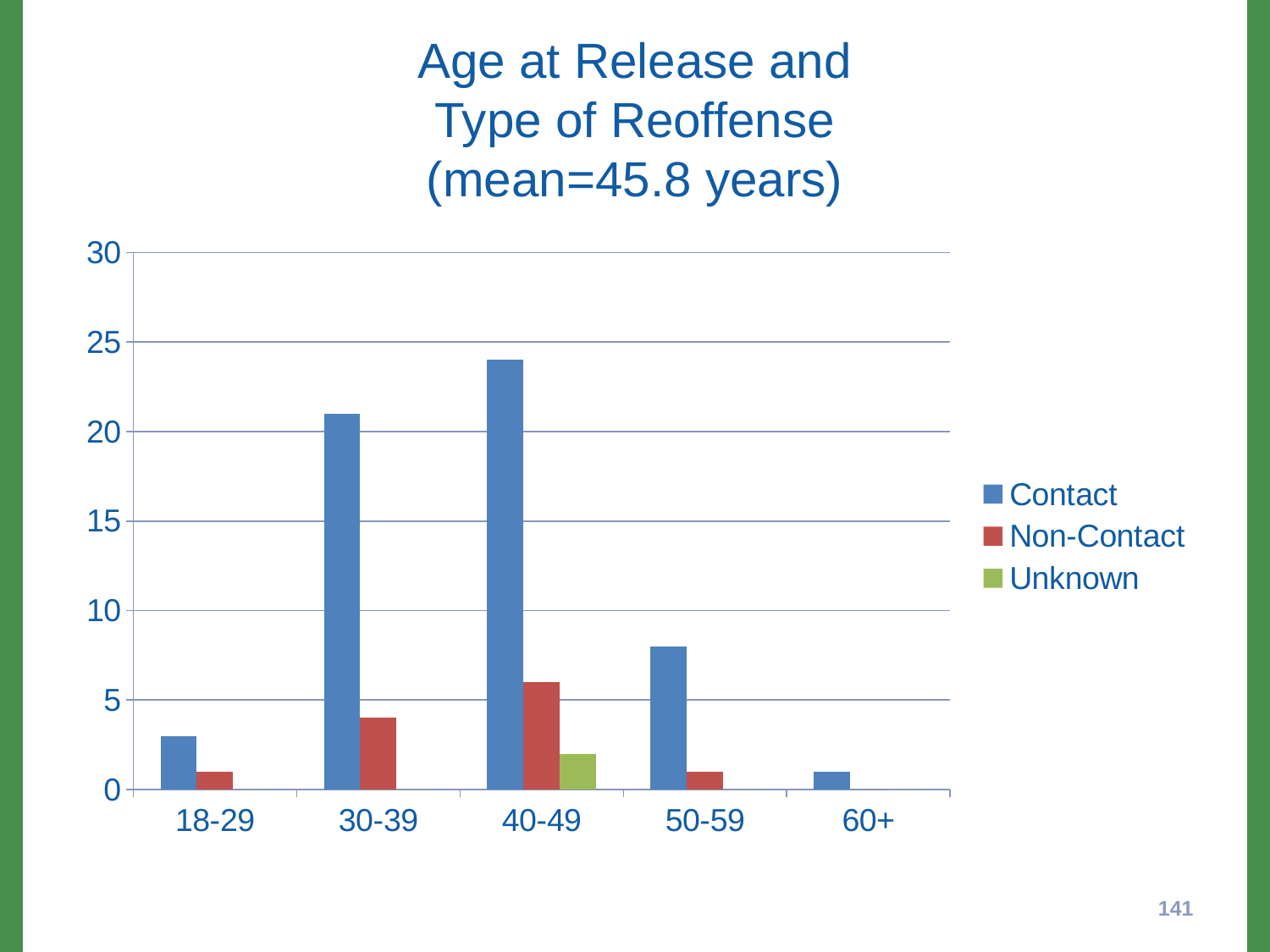
Is the Non-Contact value for 40-49 greater or less than 5? greater Which age group is the only one with a visible Unknown bar? 40-49 How many age categories are shown on the x axis? 5 What kind of chart is shown on the slide? bar chart Which age group has the lowest Contact value? 60+ Is the Contact value for 40-49 greater or less than 25? less Is the Contact value for 50-59 greater or less than 10? less How many series does the legend list? 3 Which age group has the highest Non-Contact value? 40-49 Which is larger, the Contact value for 18-29 or the Contact value for 50-59? 50-59 Which age group has the highest Contact value? 40-49